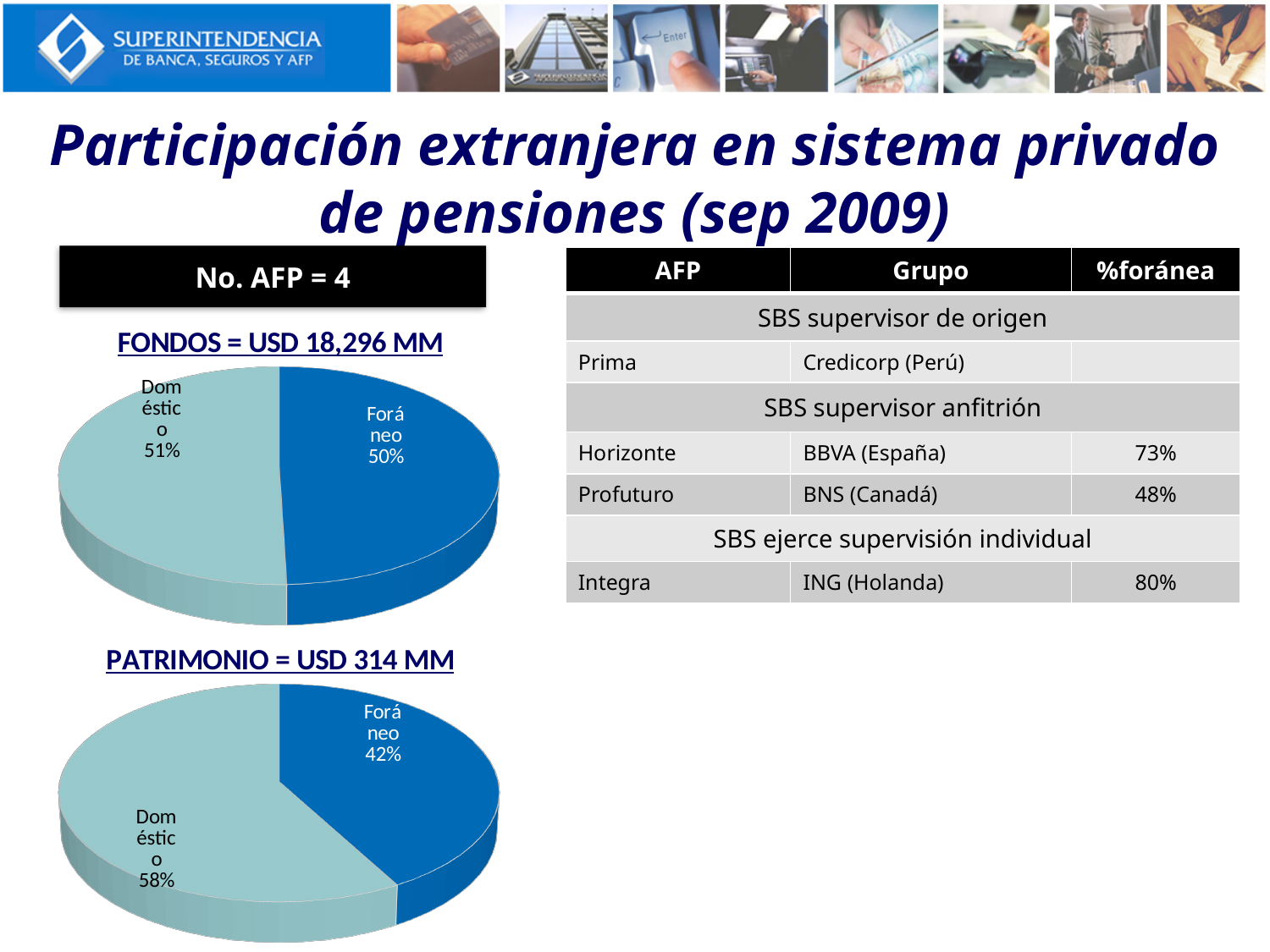
In the FONDOS = USD 18,296 MM pie chart, what share is labelled for Foráneo? 50% What is the title of the upper pie chart on the slide? FONDOS = USD 18,296 MM What type of chart is used for PATRIMONIO = USD 314 MM? Pie chart In the PATRIMONIO = USD 314 MM pie chart, which slice is the smallest? Foráneo In the PATRIMONIO = USD 314 MM pie chart, what share is labelled for Doméstico? 58% In the PATRIMONIO = USD 314 MM pie chart, what share is labelled for Foráneo? 42% How many slices does the FONDOS = USD 18,296 MM pie chart have? 2 How many slices does the PATRIMONIO = USD 314 MM pie chart have? 2 In the PATRIMONIO = USD 314 MM pie chart, what is the difference in percentage points between the Doméstico and Foráneo slices? 16 In the PATRIMONIO = USD 314 MM pie chart, which slice is larger, Doméstico or Foráneo? Doméstico In the PATRIMONIO = USD 314 MM pie chart, what colour is the Foráneo slice? Dark blue In the FONDOS = USD 18,296 MM pie chart, what share is labelled for Doméstico? 51%